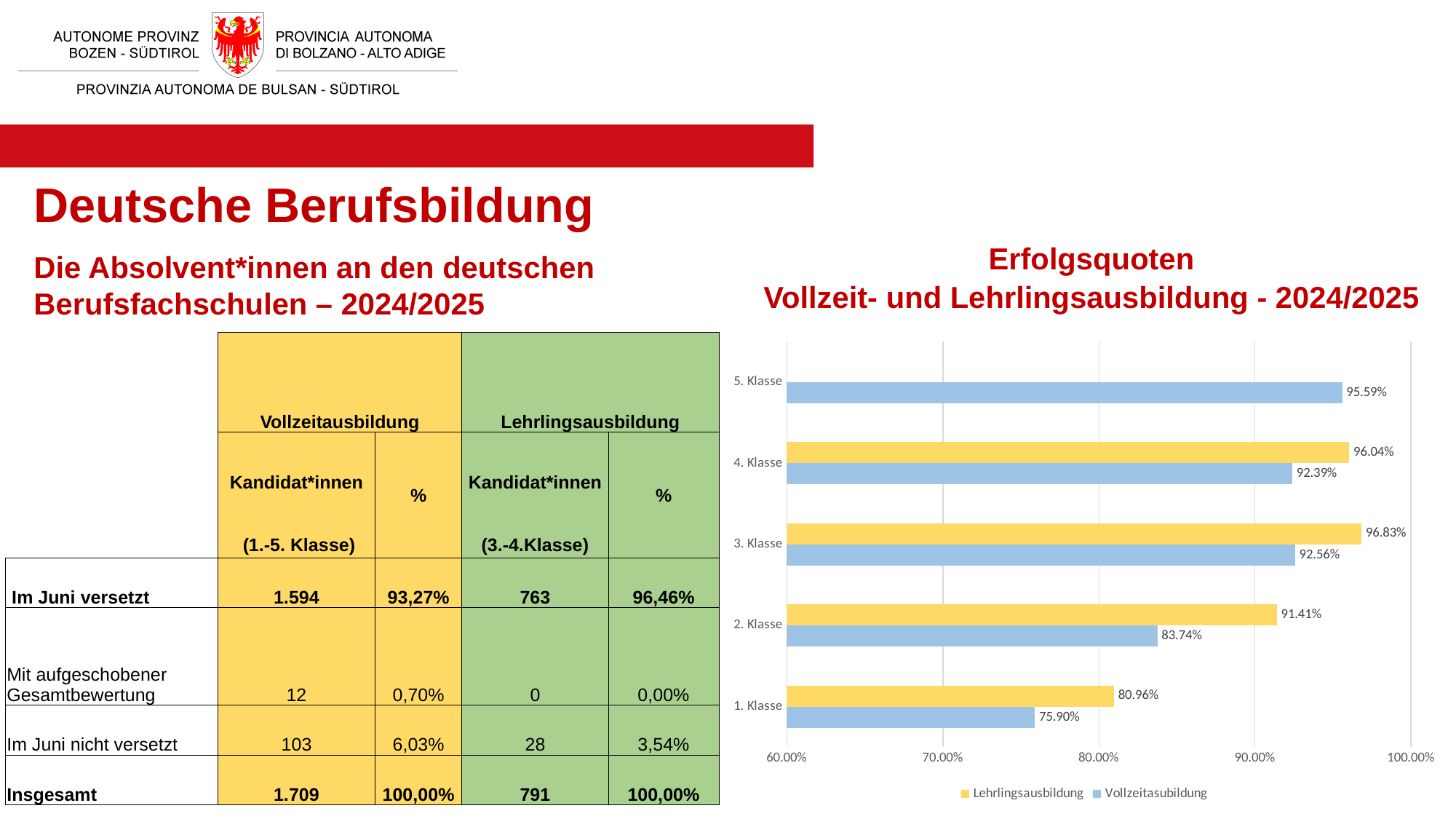
What is the difference between the Lehrlingsausbildung and Vollzeitausbildung values for 4. Klasse? 3.65 percentage points For 2. Klasse, which is larger: the Lehrlingsausbildung value or the Vollzeitausbildung value? Lehrlingsausbildung What type of chart is shown on the slide? Bar chart What is the Lehrlingsausbildung value for 2. Klasse? 91.41% Which Klasse has the lowest Vollzeitausbildung value? 1. Klasse What is the Vollzeitausbildung value for 5. Klasse? 95.59% How many Klasse categories are shown on the chart? 5 What is the Lehrlingsausbildung value for 3. Klasse? 96.83% Which Klasse has the highest Lehrlingsausbildung value? 3. Klasse How many series does the legend list? 2 What is the Vollzeitausbildung value for 1. Klasse? 75.90% What is the title of the chart? Erfolgsquoten Vollzeit- und Lehrlingsausbildung - 2024/2025